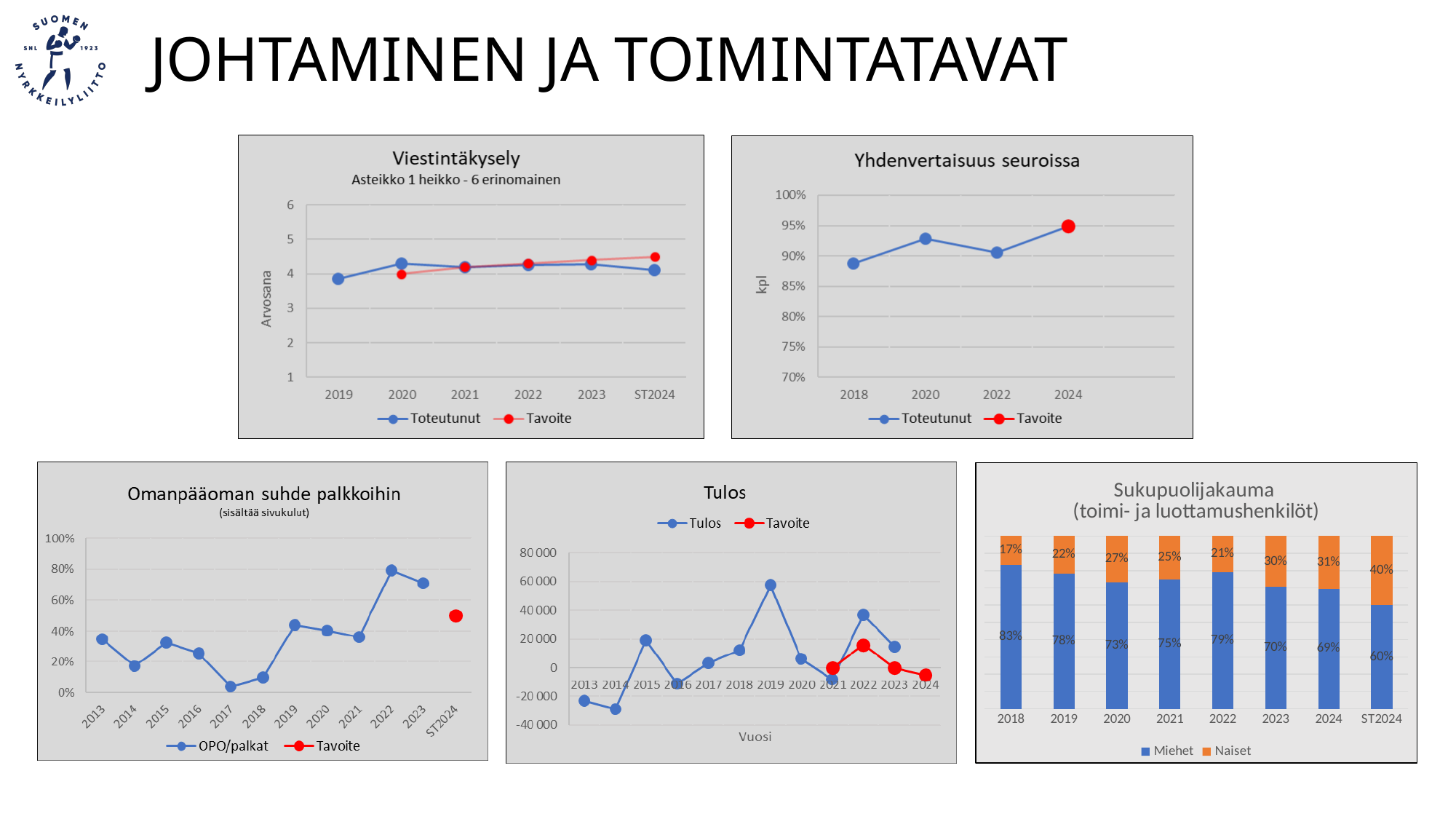
In the Sukupuolijakauma chart, which year has the lowest share of Naiset? 2018 In the Omanpääoman suhde palkkoihin chart, which year has the lowest OPO/palkat value? 2017 What kind of chart is the Tulos chart? Line chart In the Sukupuolijakauma chart, what is the value for Miehet in 2018? 83% In the Yhdenvertaisuus seuroissa chart, is the Toteutunut value for 2018 greater or less than 90%? less In the Tulos chart, which year has the highest Tulos value? 2019 In the Viestintäkysely chart, how many categories are shown on the x axis? 6 In the Sukupuolijakauma chart, what is the difference between the Miehet share in 2018 and in ST2024? 23 percentage points In the Sukupuolijakauma chart, which year has the highest share of Naiset? ST2024 In the Sukupuolijakauma chart, how many years are shown on the x axis? 8 In the Sukupuolijakauma chart, how many series does the legend list? 2 In the Sukupuolijakauma chart, what is the value for Naiset in 2023? 30%